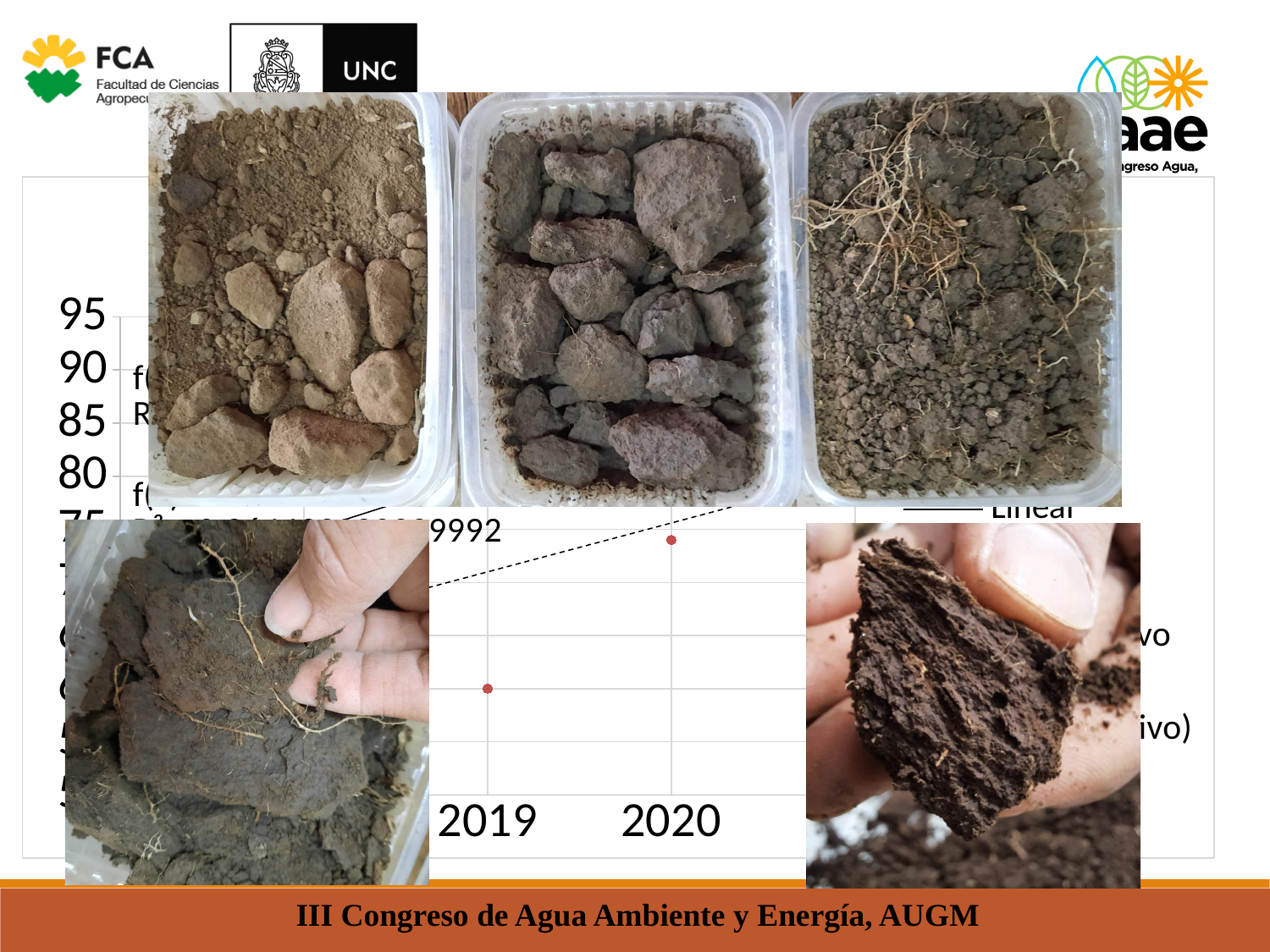
Which of the two plotted points, 2019 or 2020, has the higher value? 2020 Is the value plotted for 2020 greater or less than 80? less Do the plotted values rise or fall from 2019 to 2020? rise Which of the two labelled years, 2019 or 2020, has the lower plotted value? 2019 Is the value plotted for 2019 greater or less than 75? less What style of line connects the trend across the plotted points? dashed line